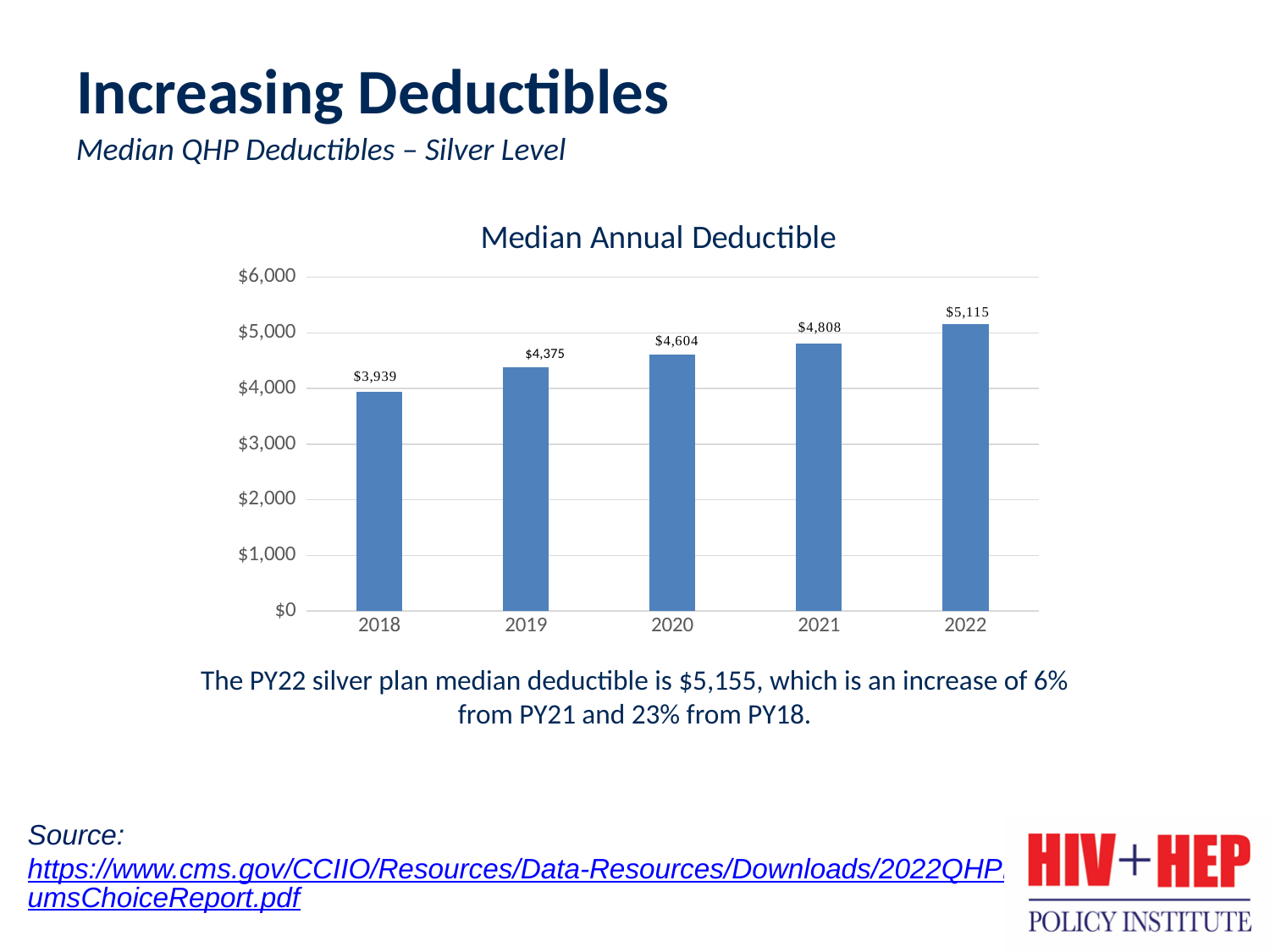
How many years are shown on the chart? 5 What is the median annual deductible for 2020? $4,604 What is the difference between the median annual deductible in 2021 and in 2020? $204 What is the median annual deductible for 2022? $5,115 What kind of chart is shown on the slide? Bar chart What is the median annual deductible for 2018? $3,939 Do the median annual deductible values rise or fall from 2018 to 2022? Rise Is the median annual deductible for 2019 greater or less than $4,000? greater Which year has the lowest median annual deductible? 2018 What is the difference between the median annual deductible in 2022 and in 2018? $1,176 Which year has the highest median annual deductible? 2022 Which year has a larger median annual deductible, 2019 or 2021? 2021